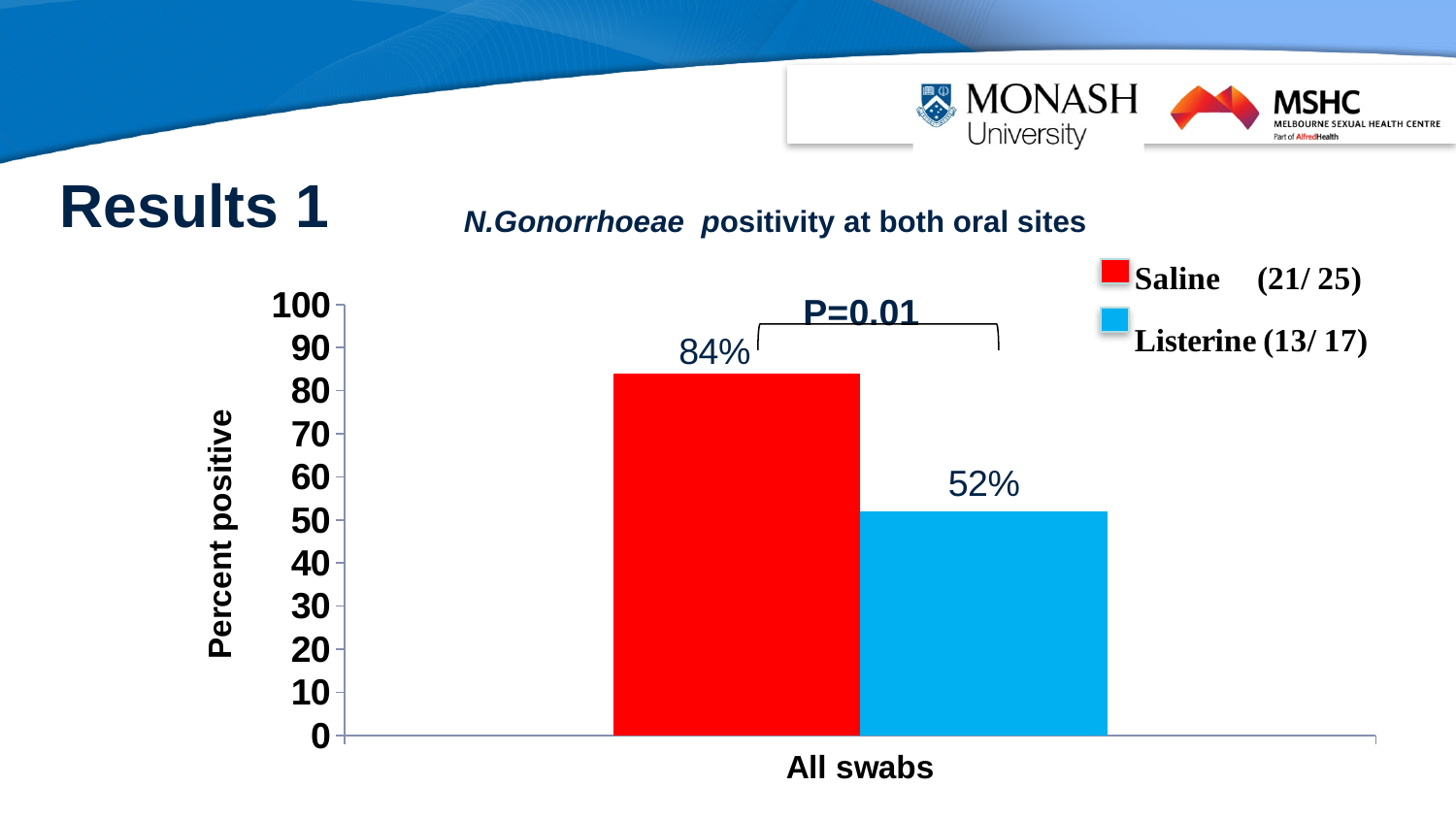
How many categories are shown on the x axis? 1 What is the percent positive for Saline in the All swabs category? 84% Is the value for Saline greater or less than 80? greater What is the label of the y axis? Percent positive What P value is shown above the bars? P=0.01 What is the difference in percent positive between Saline and Listerine? 32% Which series has the lowest percent positive? Listerine What is the percent positive for Listerine in the All swabs category? 52% What kind of chart is shown on the slide? Bar chart Which series has the higher percent positive, Saline or Listerine? Saline How many series does the legend list? 2 Is the value for Listerine greater or less than 60? less